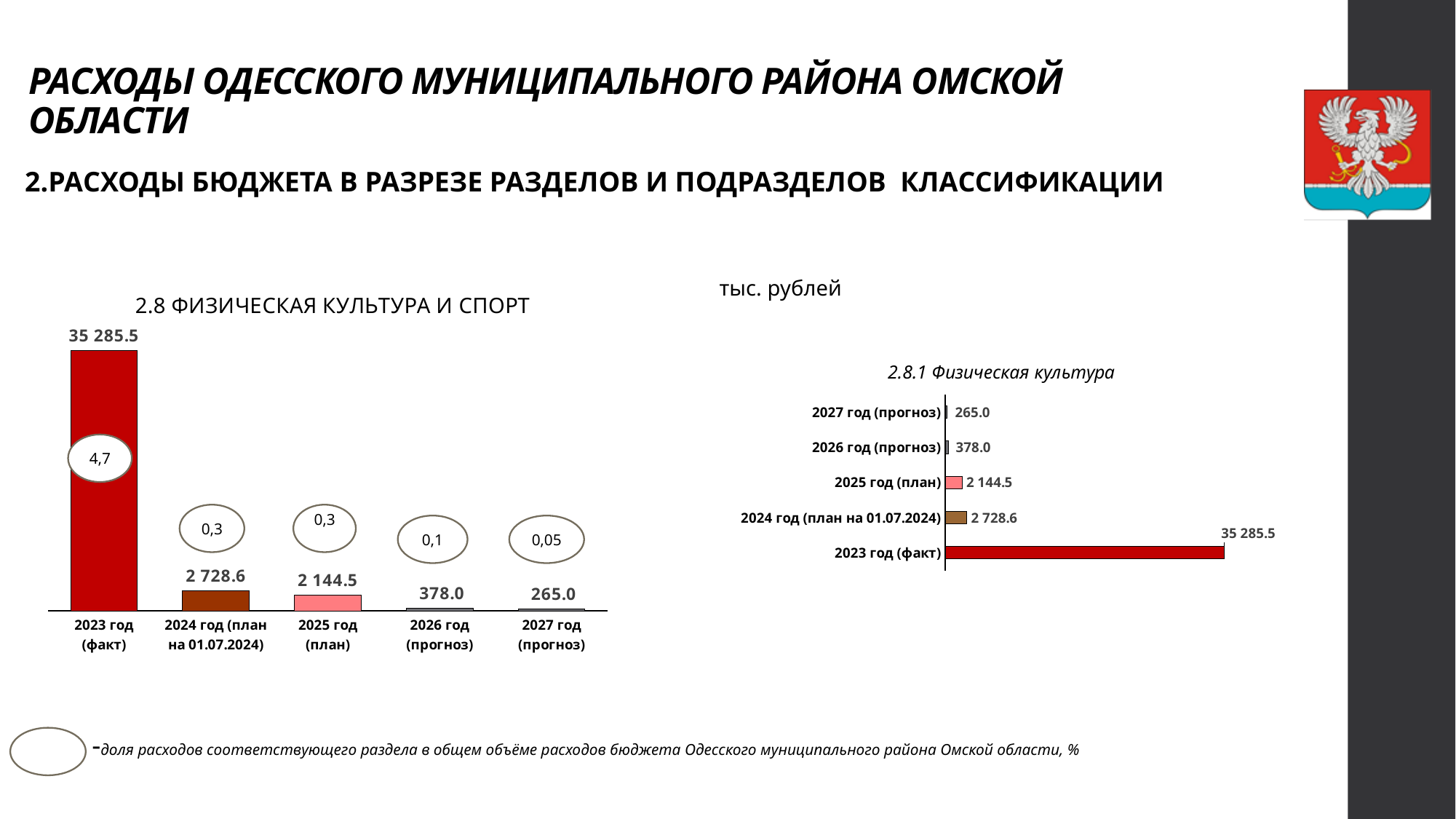
In the chart '2.8 ФИЗИЧЕСКАЯ КУЛЬТУРА И СПОРТ', what is the difference between the values for 2024 год (план на 01.07.2024) and 2025 год (план)? 584.1 In the chart '2.8 ФИЗИЧЕСКАЯ КУЛЬТУРА И СПОРТ', how many categories are shown on the x axis? 5 In the chart '2.8 ФИЗИЧЕСКАЯ КУЛЬТУРА И СПОРТ', what is the value for 2025 год (план)? 2 144.5 In the chart '2.8.1 Физическая культура', which is larger, the value for 2024 год (план на 01.07.2024) or 2027 год (прогноз)? 2024 год (план на 01.07.2024) In the chart '2.8 ФИЗИЧЕСКАЯ КУЛЬТУРА И СПОРТ', which category has the highest value? 2023 год (факт) In the chart '2.8 ФИЗИЧЕСКАЯ КУЛЬТУРА И СПОРТ', what is the value for 2023 год (факт)? 35 285.5 In the chart '2.8 ФИЗИЧЕСКАЯ КУЛЬТУРА И СПОРТ', do the values rise or fall from 2023 год (факт) to 2027 год (прогноз)? fall In the chart '2.8 ФИЗИЧЕСКАЯ КУЛЬТУРА И СПОРТ', which category has the lowest value? 2027 год (прогноз) What kind of chart is '2.8.1 Физическая культура'? bar chart In the chart '2.8.1 Физическая культура', what is the difference between the values for 2026 год (прогноз) and 2027 год (прогноз)? 113.0 In the chart '2.8 ФИЗИЧЕСКАЯ КУЛЬТУРА И СПОРТ', what share of total budget expenditure (in the oval) is shown for 2023 год (факт)? 4,7 In the chart '2.8.1 Физическая культура', what is the value for 2026 год (прогноз)? 378.0